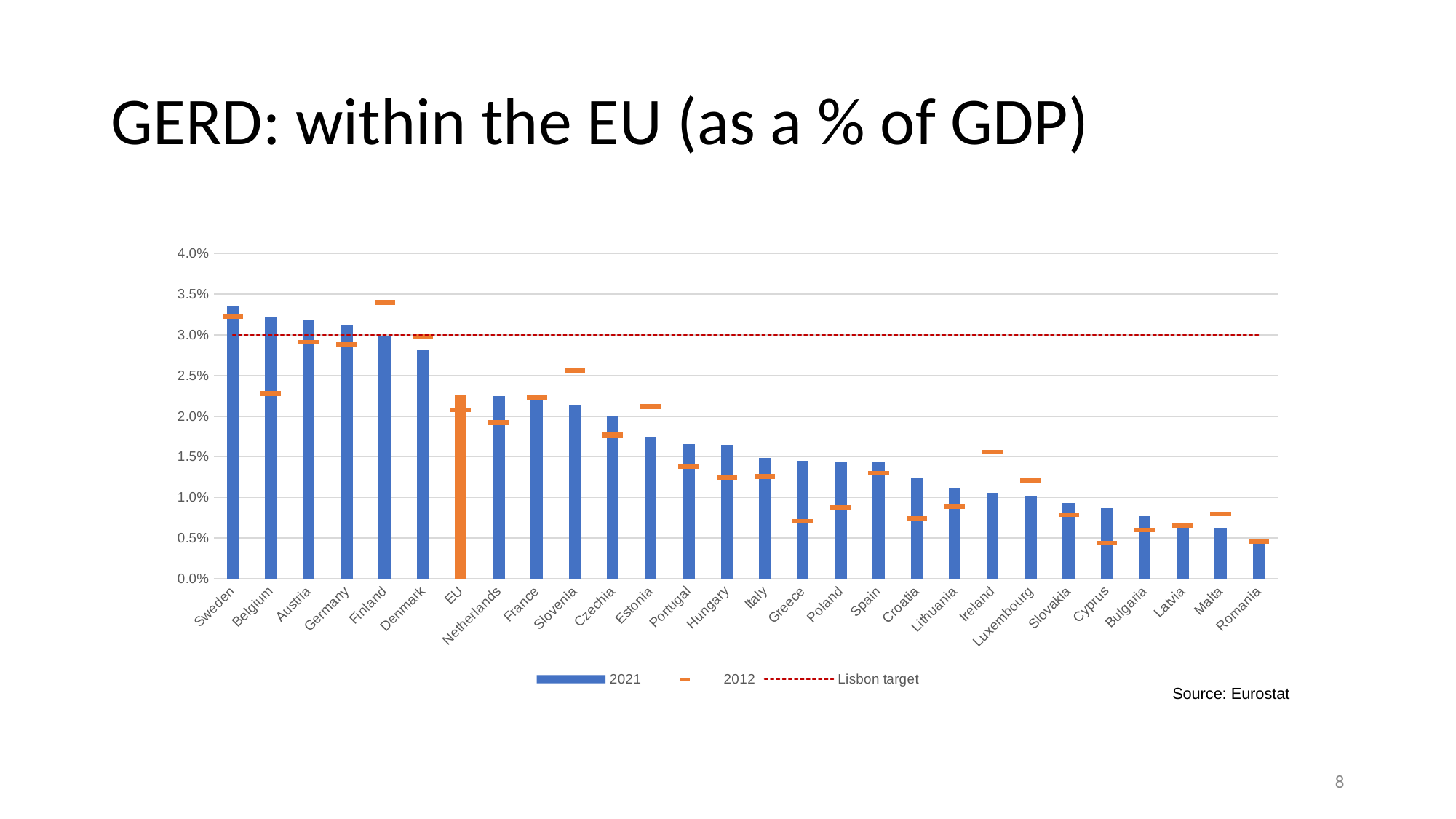
At what level is the Lisbon target line drawn? 3.0% What kind of chart is shown on the slide? bar chart Which category has the lowest 2021 value? Romania Is the 2021 value for Sweden greater or less than 3.0%? greater Do the 2021 values rise or fall moving from left to right along the x axis? fall Is the 2021 value for Denmark greater or less than 3.0%? less How many countries/regions are shown on the x axis? 28 Is the 2012 value for Finland greater or less than 3.0%? greater For Finland, which is larger: the 2012 value or the 2021 value? 2012 How many series does the legend list? 3 Which category has the highest 2021 value? Sweden